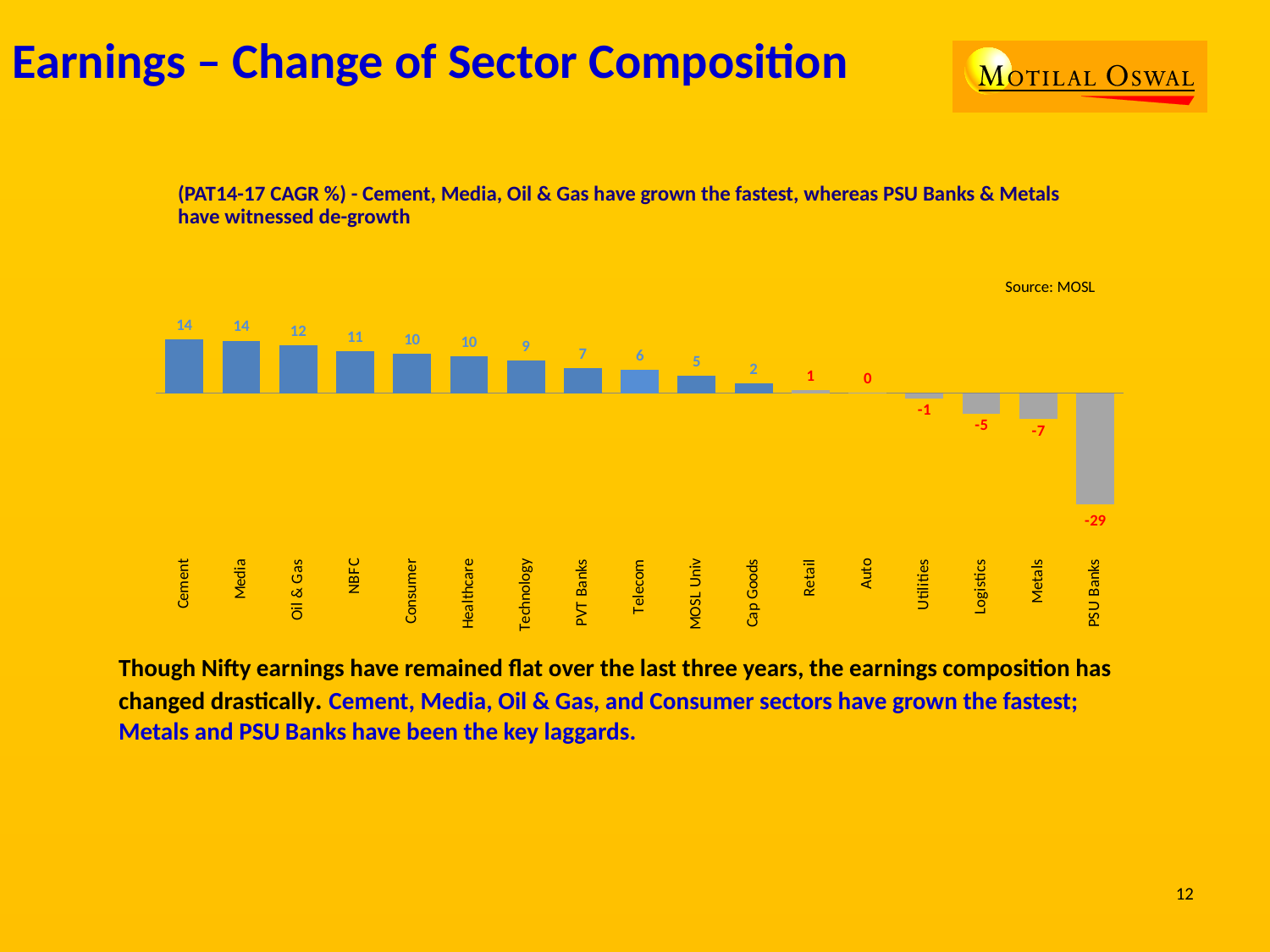
What is the value for Oil & Gas? 12 What kind of chart is shown on the slide? Bar chart What is the value for Auto? 0 Do the values rise or fall moving from left to right along the x axis? Fall Which is larger, the value for Healthcare or the value for PVT Banks? Healthcare Which is larger, the value for Logistics or the value for Utilities? Utilities Which category has the lowest value? PSU Banks What is the value for Technology? 9 How many categories are shown in the chart? 17 What is the difference between the values for NBFC and Telecom? 5 What is the value for PSU Banks? -29 What is the difference between the values for Metals and PSU Banks? 22